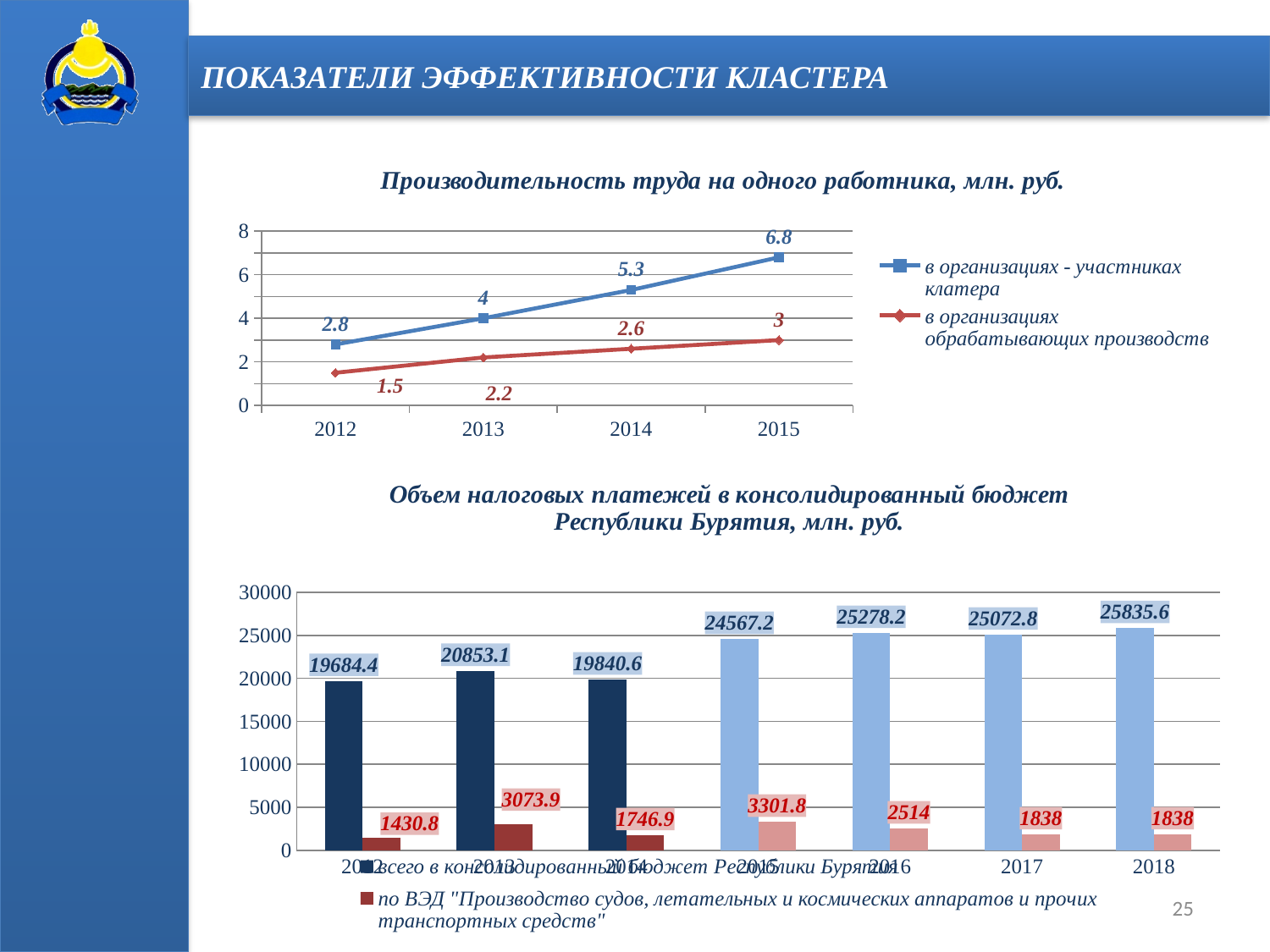
How many years are shown on the x axis of the bottom chart 'Объем налоговых платежей в консолидированный бюджет Республики Бурятия, млн. руб.'? 7 In the bottom chart 'Объем налоговых платежей в консолидированный бюджет Республики Бурятия, млн. руб.', what is the value for 'всего в консолидированный бюджет Республики Бурятия' in 2016? 25278.2 In the bottom chart 'Объем налоговых платежей в консолидированный бюджет Республики Бурятия, млн. руб.', in which year is the value for 'всего в консолидированный бюджет Республики Бурятия' highest? 2018 In the top chart 'Производительность труда на одного работника, млн. руб.', does the series 'в организациях - участниках клатера' rise or fall from 2012 to 2015? rise In the top chart 'Производительность труда на одного работника, млн. руб.', what is the value for 'в организациях обрабатывающих производств' in 2013? 2.2 In the bottom chart 'Объем налоговых платежей в консолидированный бюджет Республики Бурятия, млн. руб.', in which year is the value for the series 'по ВЭД "Производство судов, летательных и космических аппаратов и прочих транспортных средств"' lowest? 2012 How many series does the legend of the top chart 'Производительность труда на одного работника, млн. руб.' list? 2 What kind of chart is the top chart 'Производительность труда на одного работника, млн. руб.'? line chart In the bottom chart 'Объем налоговых платежей в консолидированный бюджет Республики Бурятия, млн. руб.', which is larger for the series 'по ВЭД ...': the value in 2013 or in 2015? 2015 What kind of chart is the bottom chart 'Объем налоговых платежей в консолидированный бюджет Республики Бурятия, млн. руб.'? bar chart In the top chart 'Производительность труда на одного работника, млн. руб.', what is the value for 'в организациях - участниках клатера' in 2015? 6.8 In the top chart 'Производительность труда на одного работника, млн. руб.', what is the difference between the two series in 2014? 2.7